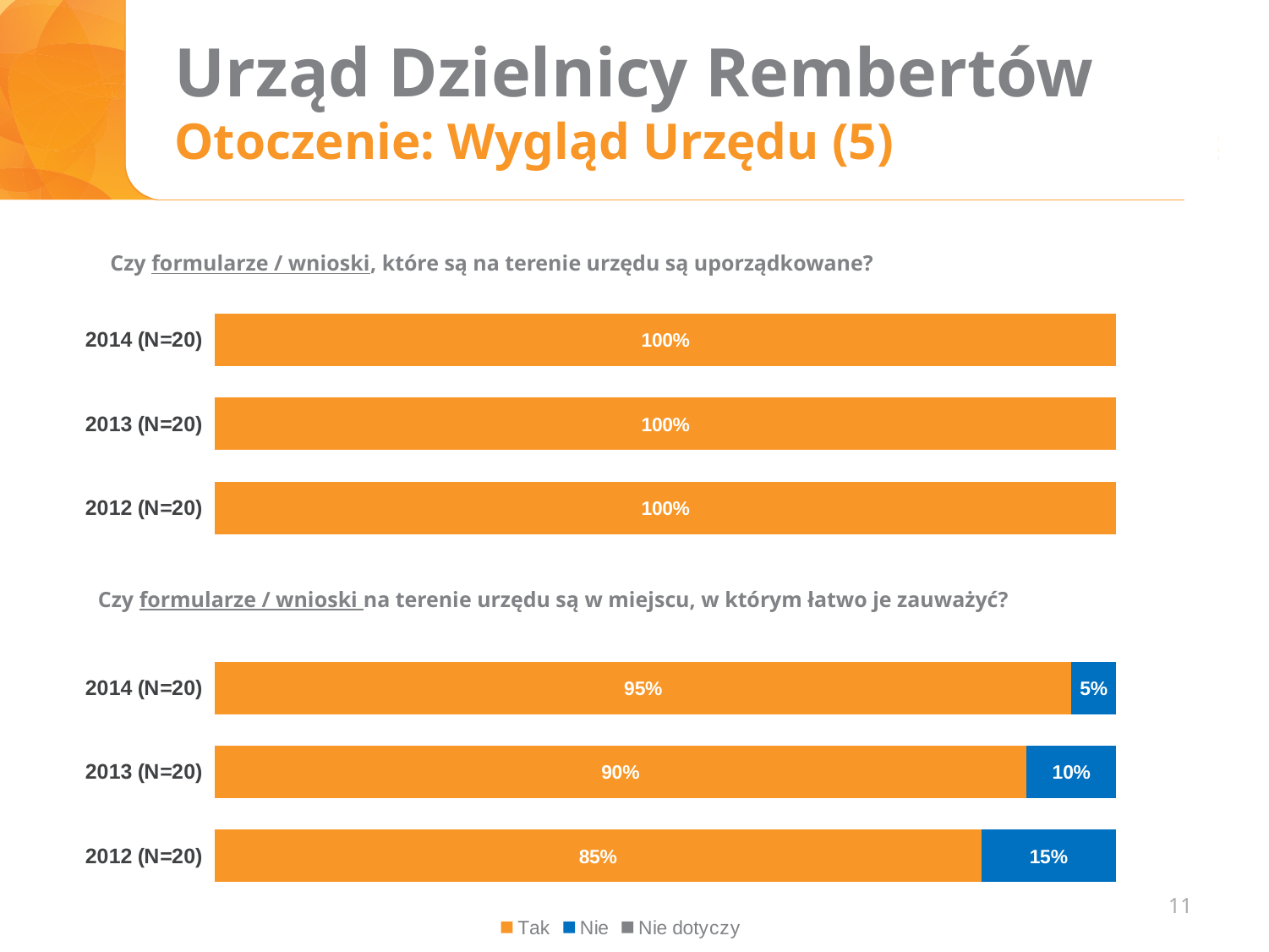
In the bottom chart, what is the 'Tak' value for 2013 (N=20)? 90% In the bottom chart, what is the total of the 'Tak' and 'Nie' segments for 2013 (N=20)? 100% In the bottom chart, which year has the highest 'Tak' share? 2014 (N=20) In the bottom chart, what percentage answered 'Nie' in 2012 (N=20)? 15% In the bottom chart, is the 'Nie' share larger in 2013 or in 2014? 2013 What type of chart is the bottom chart? Stacked bar chart In the bottom chart, what is the difference between the 'Tak' values for 2014 and 2012? 10% How many series does the legend at the bottom of the slide list? 3 How many year categories does the top chart show? 3 In the bottom chart, which year has the lowest 'Tak' share? 2012 (N=20) In the bottom chart, what percentage answered 'Tak' in 2014 (N=20)? 95% In the top chart, what is the value shown for 2012 (N=20)? 100%